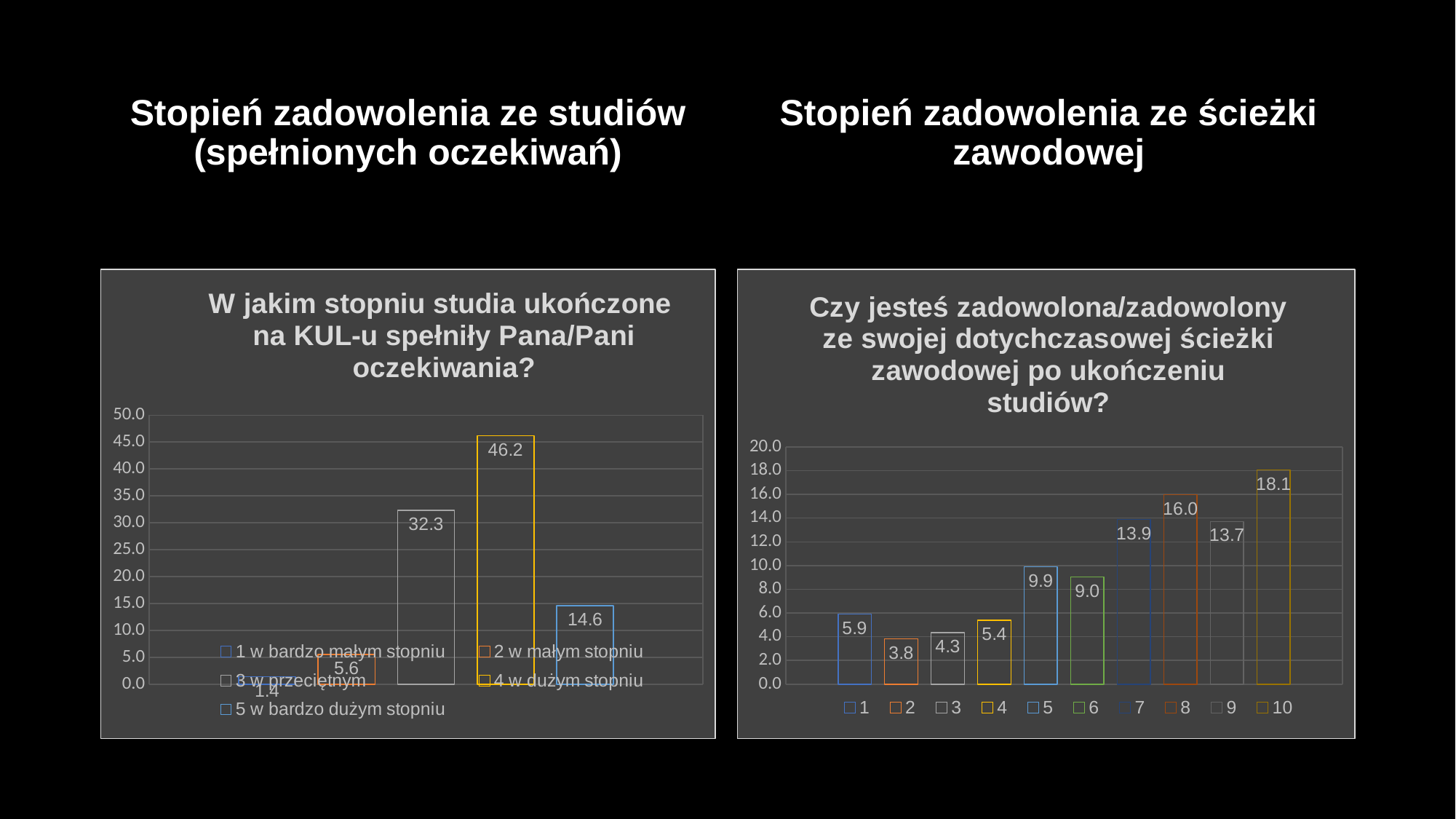
In the left chart, how many series does the legend list? 5 In the left chart, which category has the lowest value? 1 w bardzo małym stopniu In the left chart, what is the difference between the values for "4 w dużym stopniu" and "3 w przeciętnym"? 13.9 In the left chart ("W jakim stopniu studia ukończone na KUL-u spełniły Pana/Pani oczekiwania?"), what is the value for "4 w dużym stopniu"? 46.2 In the right chart, which is larger, the value for 8 or the value for 9? 8 In the right chart ("Czy jesteś zadowolona/zadowolony ze swojej dotychczasowej ścieżki zawodowej po ukończeniu studiów?"), what is the value for 10? 18.1 In the left chart, what is the value for "3 w przeciętnym"? 32.3 What type of chart is the right chart? bar chart In the right chart, which category has the lowest value? 2 In the right chart, how many categories are plotted? 10 In the left chart, is the value for "5 w bardzo dużym stopniu" greater or less than 10.0? greater In the right chart, which category has the highest value? 10